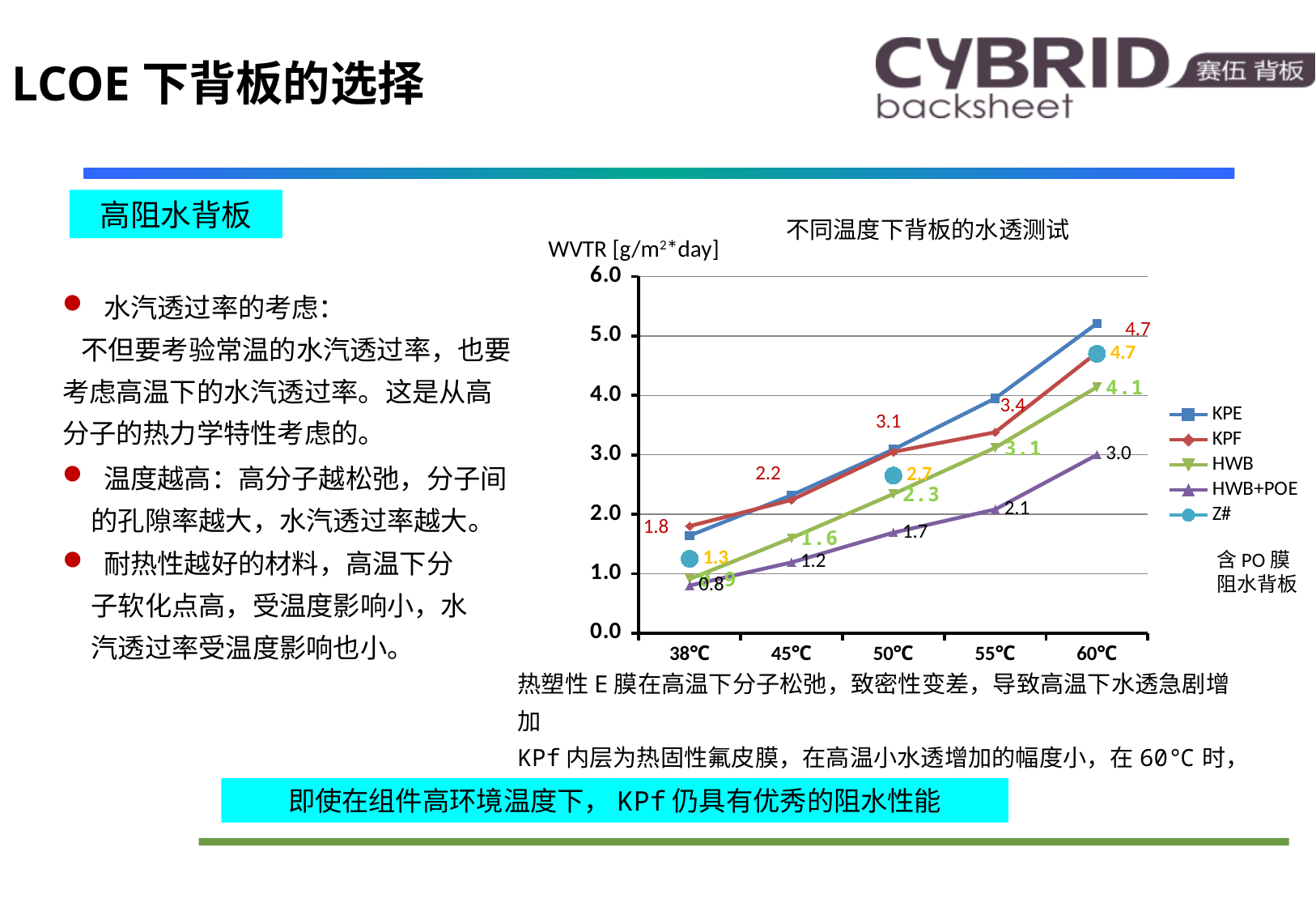
What is the WVTR value for HWB at 45℃? 1.6 What is the WVTR value for HWB+POE at 60℃? 3.0 How many series does the legend of the chart list? 5 How many temperature points are shown on the x axis of the chart? 5 Is the value for KPE at 60℃ greater or less than 5.0? greater At 55℃, which is larger, the value for KPF or the value for HWB+POE? KPF What kind of chart is shown on the slide? line chart Which series has the lowest value at 38℃? HWB+POE What is the WVTR value for Z# at 50℃? 2.7 Does the KPE series rise or fall as temperature increases from 38℃ to 60℃? rise What is the WVTR value for KPF at 60℃? 4.7 What is the difference between the KPF values at 60℃ and 38℃? 2.9